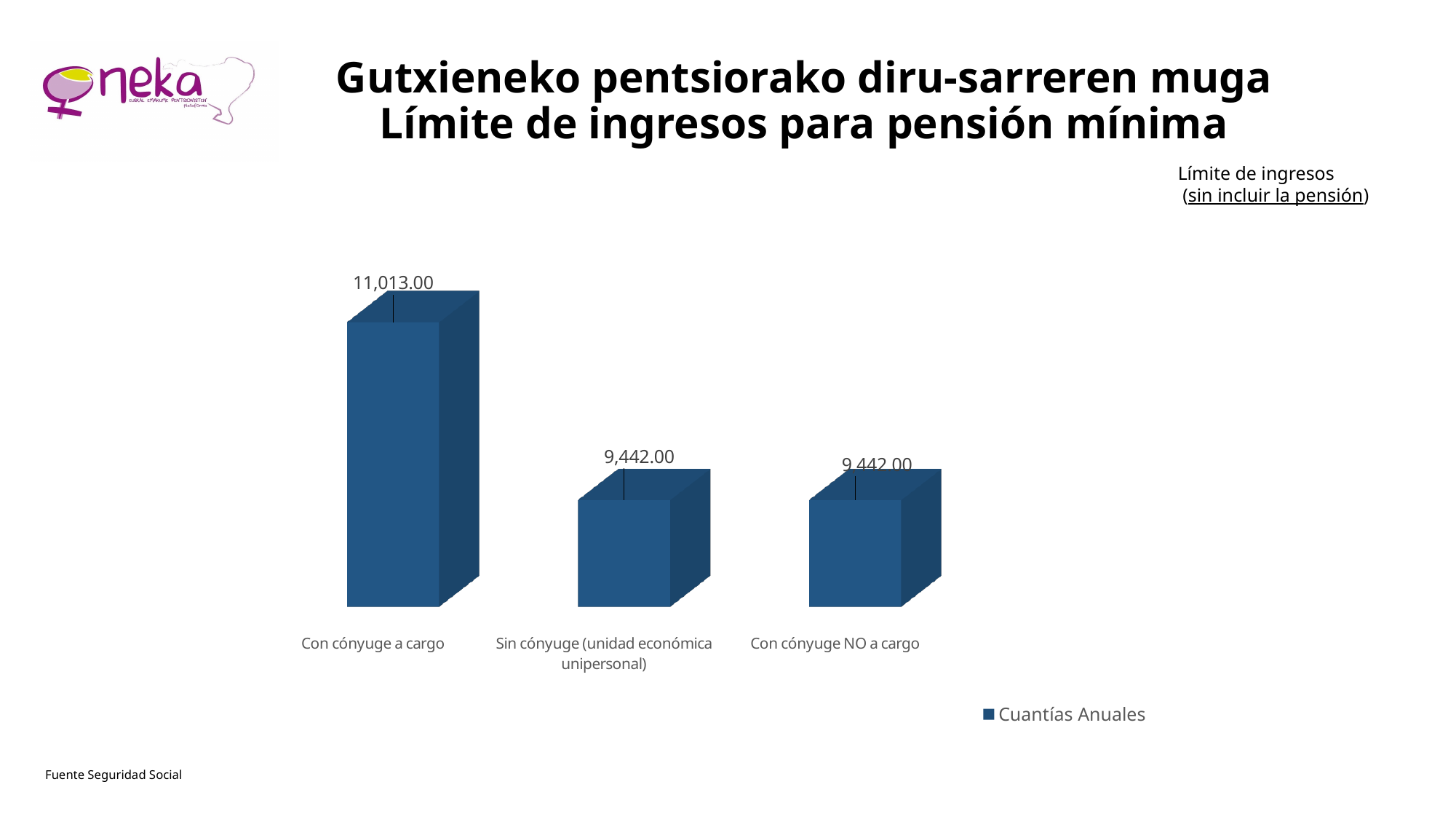
Do the values for 'Sin cónyuge (unidad económica unipersonal)' and 'Con cónyuge NO a cargo' differ? No, both are 9,442.00 Which category has the highest value? Con cónyuge a cargo What is the value for 'Con cónyuge NO a cargo'? 9,442.00 What source is cited at the bottom of the slide? Fuente Seguridad Social What is the name of the series shown in the legend? Cuantías Anuales How many series does the legend list? 1 What is the difference between the values for 'Con cónyuge a cargo' and 'Con cónyuge NO a cargo'? 1,571.00 How many categories are shown in the chart? 3 What is the value for 'Con cónyuge a cargo'? 11,013.00 Which is larger, the value for 'Con cónyuge a cargo' or the value for 'Sin cónyuge (unidad económica unipersonal)'? Con cónyuge a cargo What kind of chart is shown on the slide? Bar chart What is the value for 'Sin cónyuge (unidad económica unipersonal)'? 9,442.00